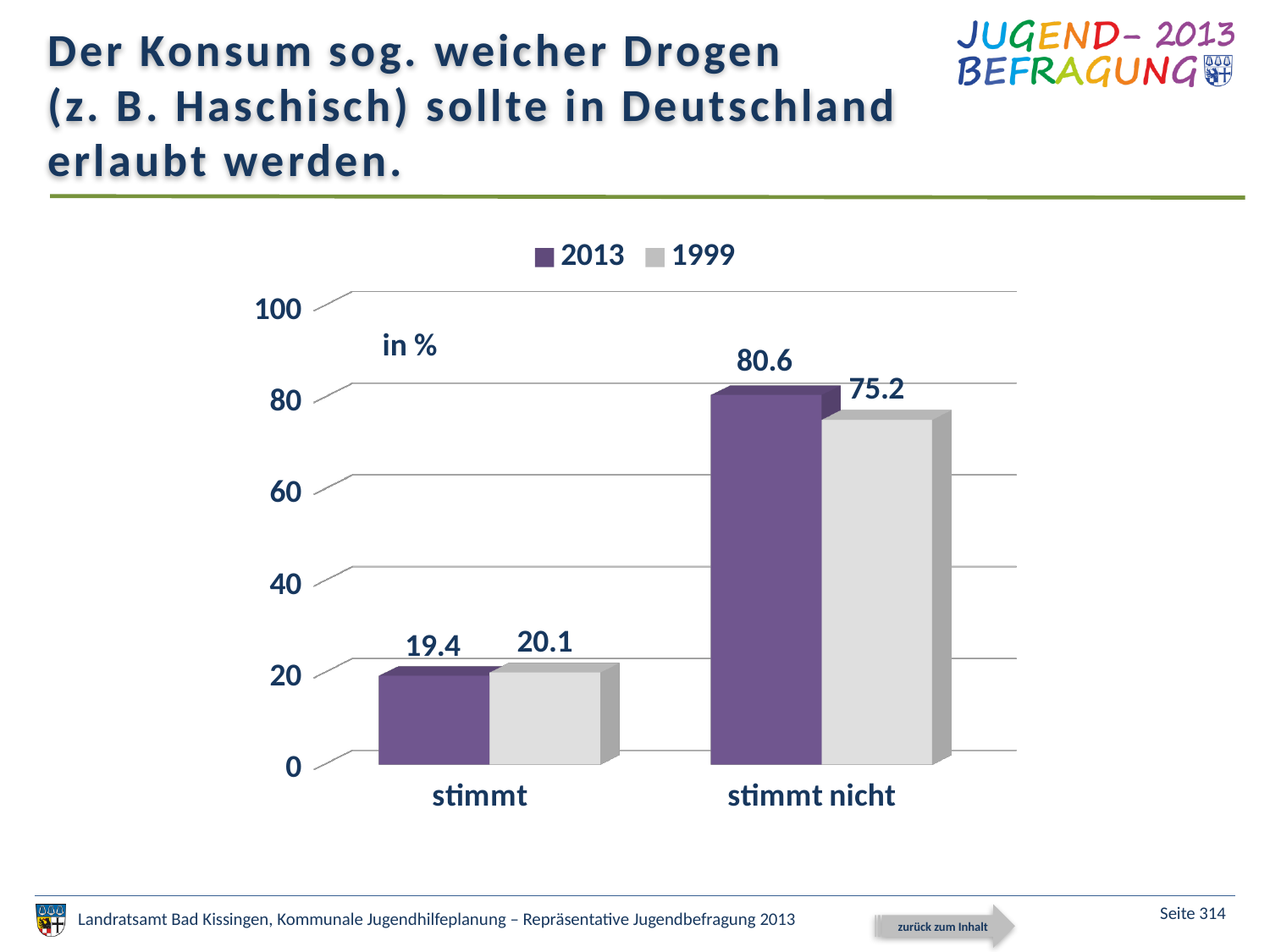
Which category has the lowest value in the 1999 series? stimmt What is the value for "stimmt" in the 1999 series? 20.1 What is the difference between the 2013 and 1999 values for "stimmt nicht"? 5.4 How many categories are shown on the x axis? 2 For "stimmt", which series has the larger value, 2013 or 1999? 1999 What is the value for "stimmt nicht" in the 2013 series? 80.6 What kind of chart is shown on the slide? bar chart What is the value for "stimmt nicht" in the 1999 series? 75.2 How many series does the legend list? 2 What is the value for "stimmt" in the 2013 series? 19.4 Which category has the highest value in the 2013 series? stimmt nicht Which series is shown in purple according to the legend? 2013